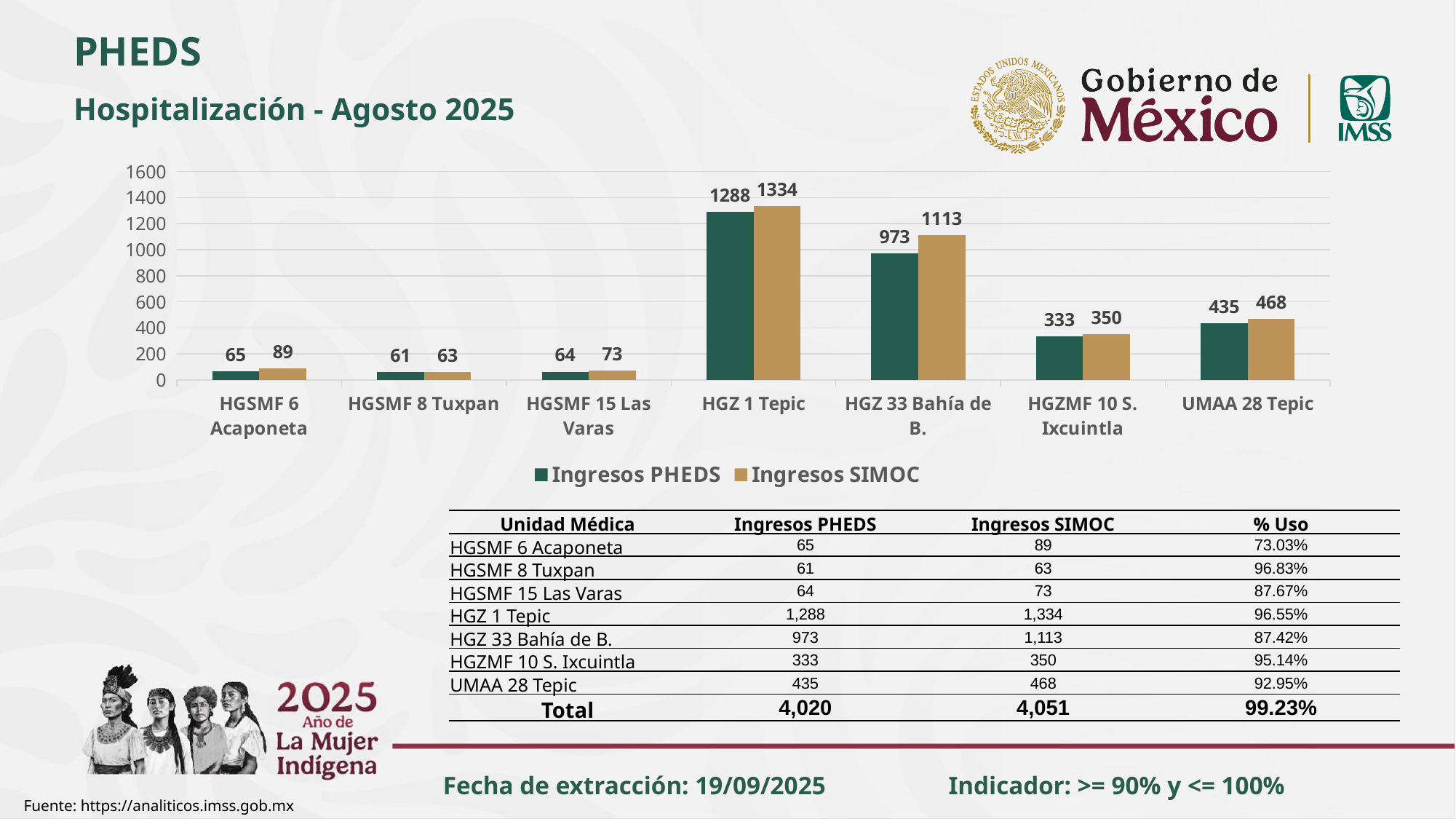
What colour are the Ingresos SIMOC bars? tan/gold What is the Ingresos PHEDS value for HGZ 1 Tepic? 1288 How many categories are shown on the x axis of the chart? 7 Which is larger for UMAA 28 Tepic: Ingresos PHEDS or Ingresos SIMOC? Ingresos SIMOC What is the Ingresos SIMOC value for HGSMF 6 Acaponeta? 89 What is the Ingresos SIMOC value for HGZ 33 Bahía de B.? 1113 What is the difference between Ingresos SIMOC and Ingresos PHEDS for HGZ 33 Bahía de B.? 140 Which category has the highest Ingresos SIMOC value? HGZ 1 Tepic How many series does the legend list? 2 Which category has the lowest Ingresos PHEDS value? HGSMF 8 Tuxpan What kind of chart is shown on the slide? bar chart Is the Ingresos PHEDS value for HGZMF 10 S. Ixcuintla greater or less than 400? less